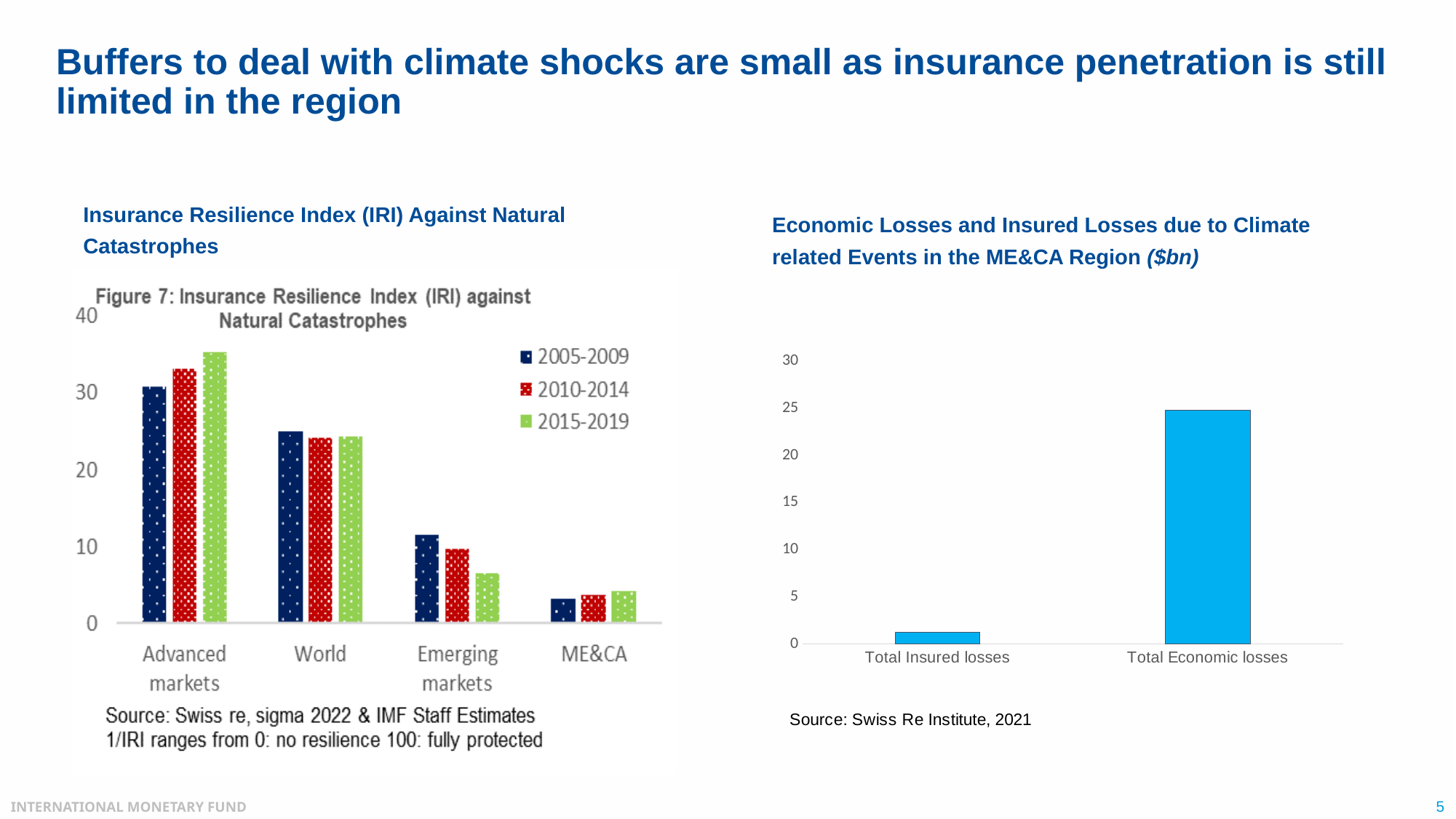
In the Insurance Resilience Index (IRI) Against Natural Catastrophes chart, is the 2015-2019 value for ME&CA greater or less than 10? less In the Economic Losses and Insured Losses due to Climate related Events in the ME&CA Region chart, which category is higher: Total Insured losses or Total Economic losses? Total Economic losses In the Insurance Resilience Index (IRI) Against Natural Catastrophes chart, which series is shown in green? 2015-2019 In the Insurance Resilience Index (IRI) Against Natural Catastrophes chart, which category has the highest values? Advanced markets In the Insurance Resilience Index (IRI) Against Natural Catastrophes chart, is the 2015-2019 value for Advanced markets greater or less than 30? greater In the Economic Losses and Insured Losses due to Climate related Events in the ME&CA Region chart, is the value for Total Economic losses greater or less than 20? greater What kind of chart is the Insurance Resilience Index (IRI) Against Natural Catastrophes chart? bar chart How many series does the legend of the Insurance Resilience Index (IRI) Against Natural Catastrophes chart list? 3 What kind of chart is the Economic Losses and Insured Losses due to Climate related Events in the ME&CA Region chart? bar chart How many categories are shown on the x axis of the Insurance Resilience Index (IRI) Against Natural Catastrophes chart? 4 In the Insurance Resilience Index (IRI) Against Natural Catastrophes chart, which category has the lowest values? ME&CA In the Insurance Resilience Index (IRI) Against Natural Catastrophes chart, which is larger for Emerging markets: the 2005-2009 value or the 2015-2019 value? 2005-2009